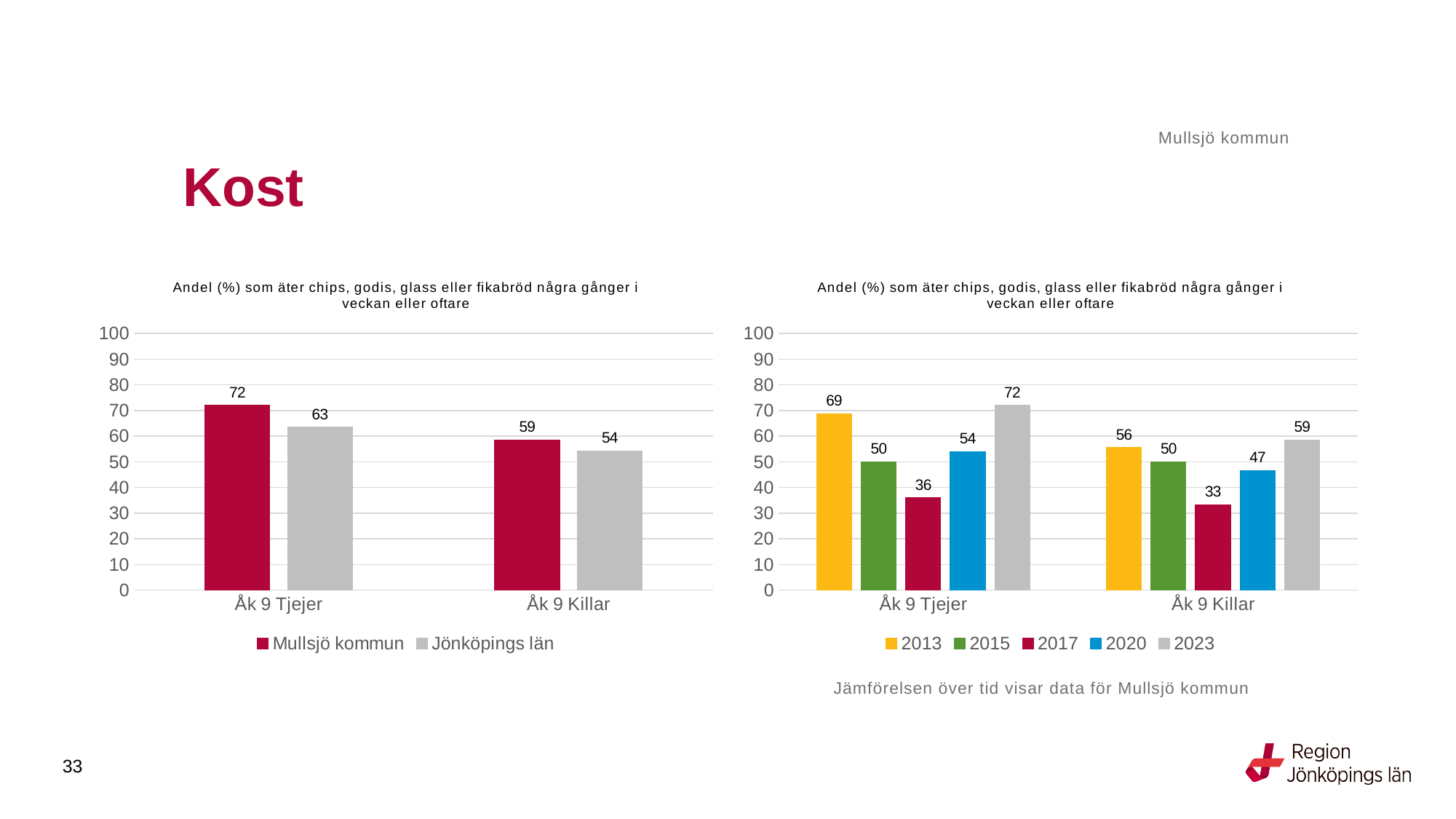
In the left chart, what is the value for Mullsjö kommun for Åk 9 Tjejer? 72 In the right chart, what is the value for 2020 for Åk 9 Killar? 47 In the left chart, how many series does the legend list? 2 In the left chart, what is the value for Jönköpings län for Åk 9 Killar? 54 In the right chart, which year has the lowest value for Åk 9 Killar? 2017 In the left chart, what is the difference between Mullsjö kommun and Jönköpings län for Åk 9 Tjejer? 9 In the right chart, what is the difference between the 2023 and 2013 values for Åk 9 Killar? 3 In the right chart, how many series does the legend list? 5 What type of chart is the right chart? Bar chart In the left chart, which is larger for Åk 9 Killar: Mullsjö kommun or Jönköpings län? Mullsjö kommun In the right chart, what is the value for 2017 for Åk 9 Tjejer? 36 In the right chart, which year has the highest value for Åk 9 Tjejer? 2023